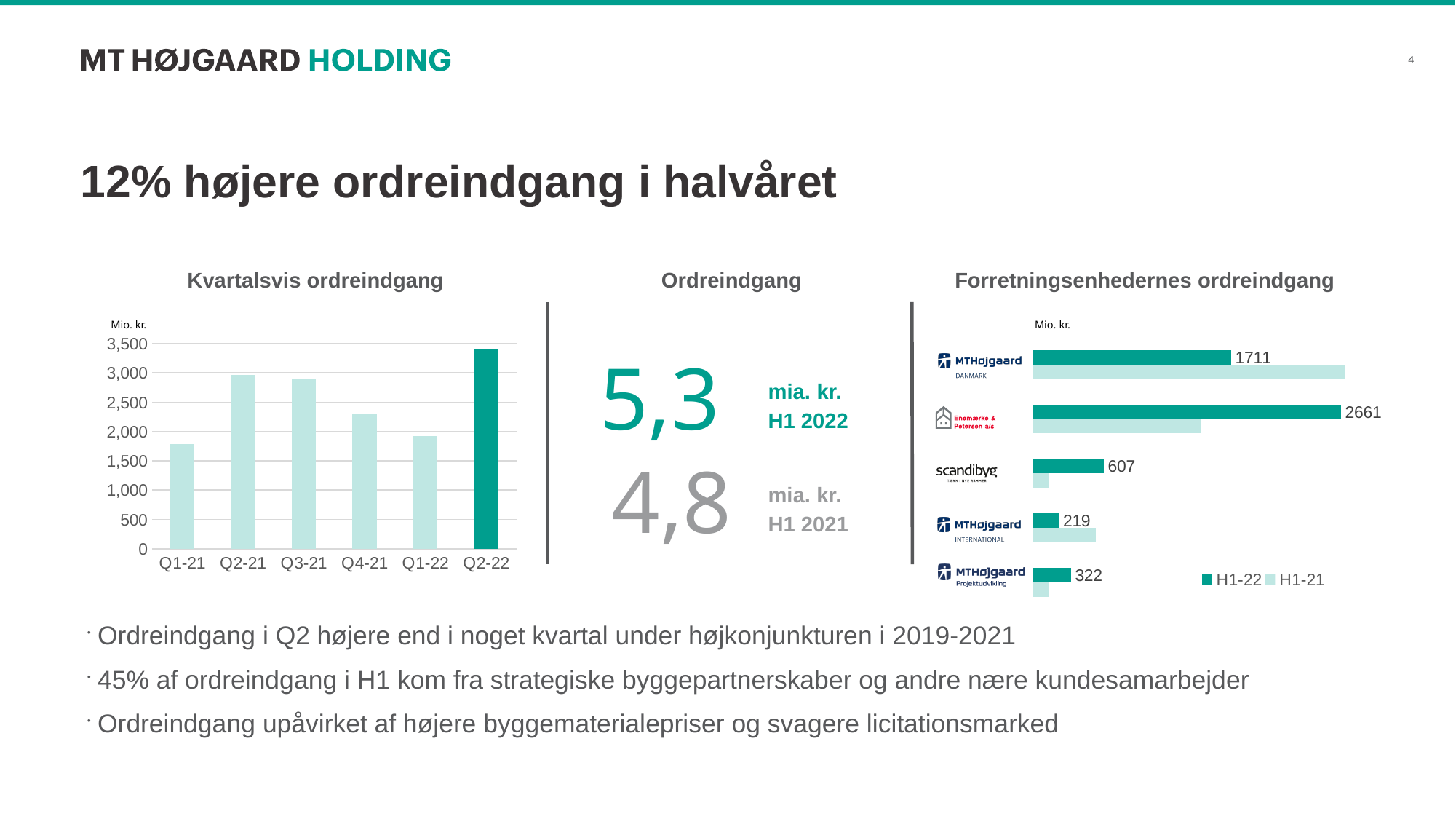
In the 'Forretningsenhedernes ordreindgang' chart, how many series does the legend list? 2 In the 'Kvartalsvis ordreindgang' chart, which is larger, the value for Q4-21 or the value for Q1-22? Q4-21 In the 'Forretningsenhedernes ordreindgang' chart, what is the H1-22 value for Scandibyg? 607 In the 'Kvartalsvis ordreindgang' chart, how many quarters are plotted? 6 In the 'Forretningsenhedernes ordreindgang' chart, what is the H1-22 value for Enemærke & Petersen? 2661 What kind of chart is the 'Kvartalsvis ordreindgang' chart? bar chart In the 'Kvartalsvis ordreindgang' chart, which quarter has the highest order intake? Q2-22 In the 'Forretningsenhedernes ordreindgang' chart, which business unit has the lowest H1-22 value? MT Højgaard International In the 'Forretningsenhedernes ordreindgang' chart, for MT Højgaard Danmark, which is larger, the H1-22 bar or the H1-21 bar? H1-21 In the 'Kvartalsvis ordreindgang' chart, is the value for Q1-21 greater or less than 2,000? less In the 'Kvartalsvis ordreindgang' chart, is the value for Q2-22 greater or less than 3,000? greater In the 'Forretningsenhedernes ordreindgang' chart, what is the difference between the H1-22 values for Enemærke & Petersen and MT Højgaard Danmark? 950